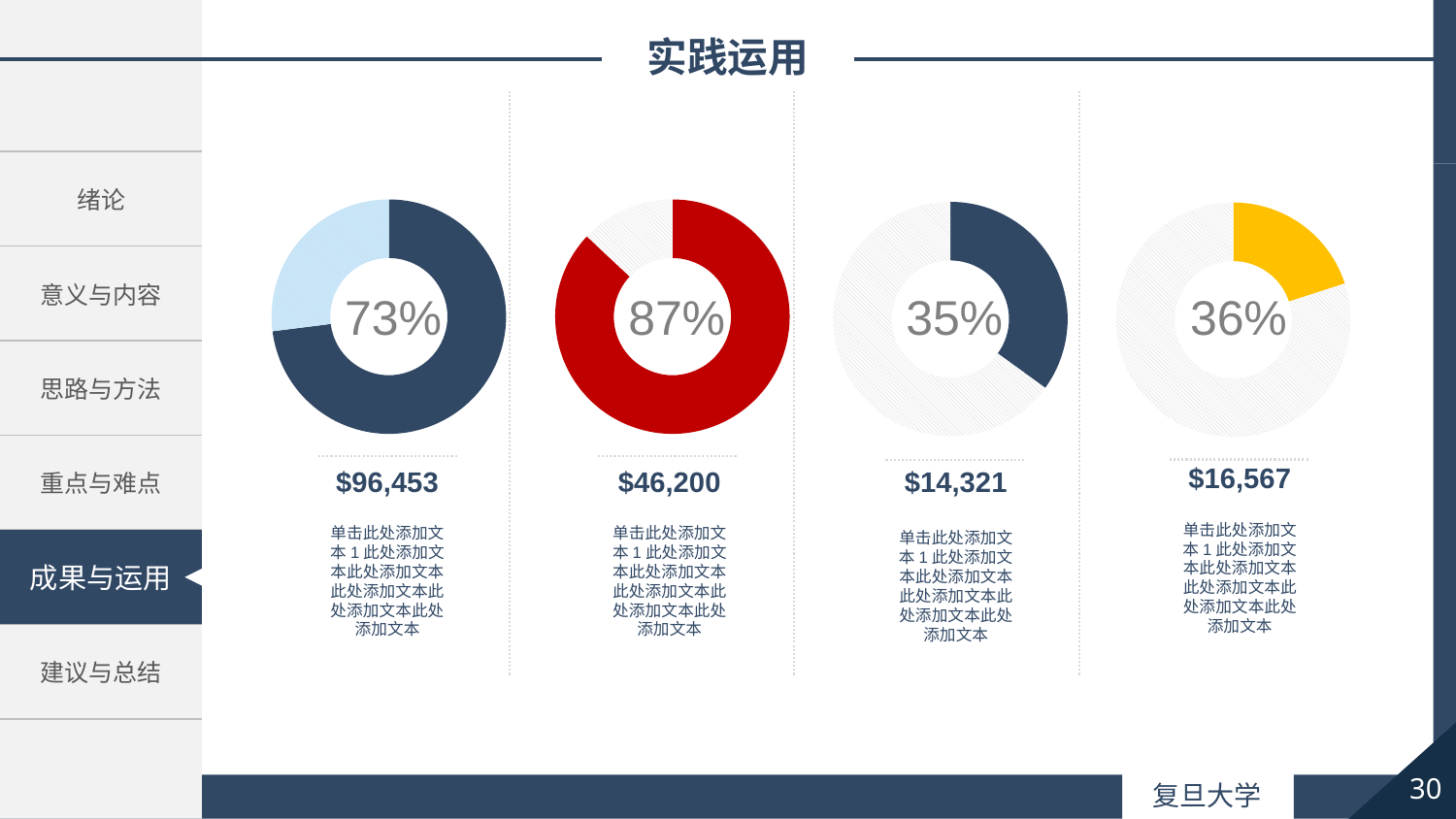
What percentage is shown in the centre of the rightmost donut chart (the yellow one)? 36% Is the percentage in the leftmost donut chart larger or smaller than the percentage in the red donut chart? Smaller Which of the four donut charts shows the highest percentage? The second from the left (red), 87% What percentage is shown in the centre of the third donut chart from the left? 35% What kind of chart is used for the four figures on the slide? Donut (pie) chart What dollar value is printed below the leftmost donut chart? $96,453 What is the difference between the percentage in the red donut chart and the percentage in the leftmost donut chart? 14% What colour is the filled segment of the rightmost donut chart? Yellow What percentage is shown in the centre of the second donut chart from the left (the red one)? 87% What percentage is shown in the centre of the leftmost donut chart? 73% How many donut charts are on the slide? 4